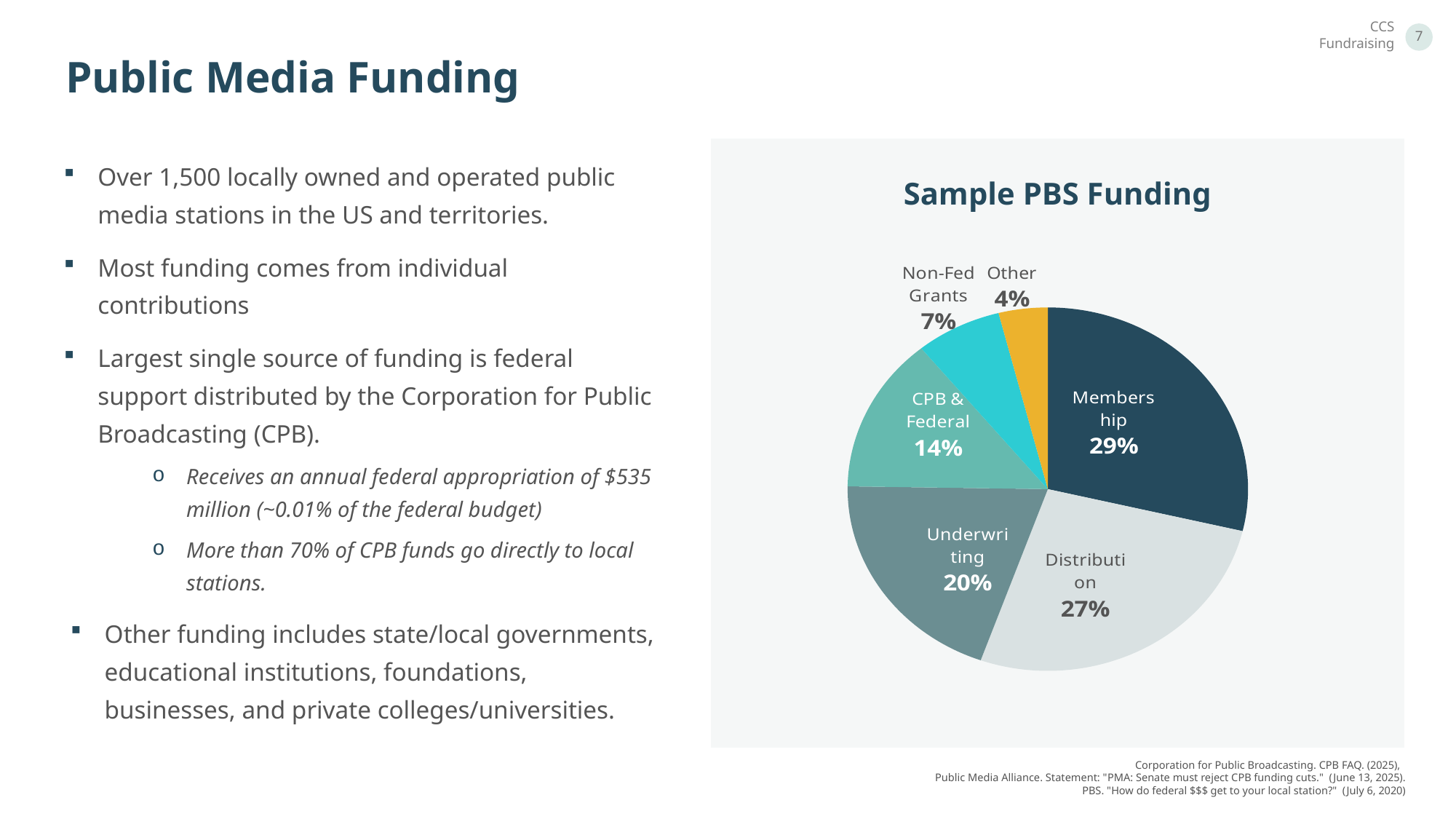
What share does CPB & Federal represent in the pie chart? 14% How many categories are shown in the pie chart? 6 What share of Sample PBS Funding comes from Membership? 29% What is the difference between the Underwriting and CPB & Federal shares? 6 percentage points Which category has the smallest slice of the pie? Other Which category has the largest slice of the pie? Membership How many percentage points larger is Membership than Distribution? 2 What is the value shown for Underwriting? 20% What percentage of the pie is labelled Distribution? 27% Which is larger, Underwriting or CPB & Federal? Underwriting What type of chart is shown on the slide? Pie chart What percentage is shown for Non-Fed Grants? 7%